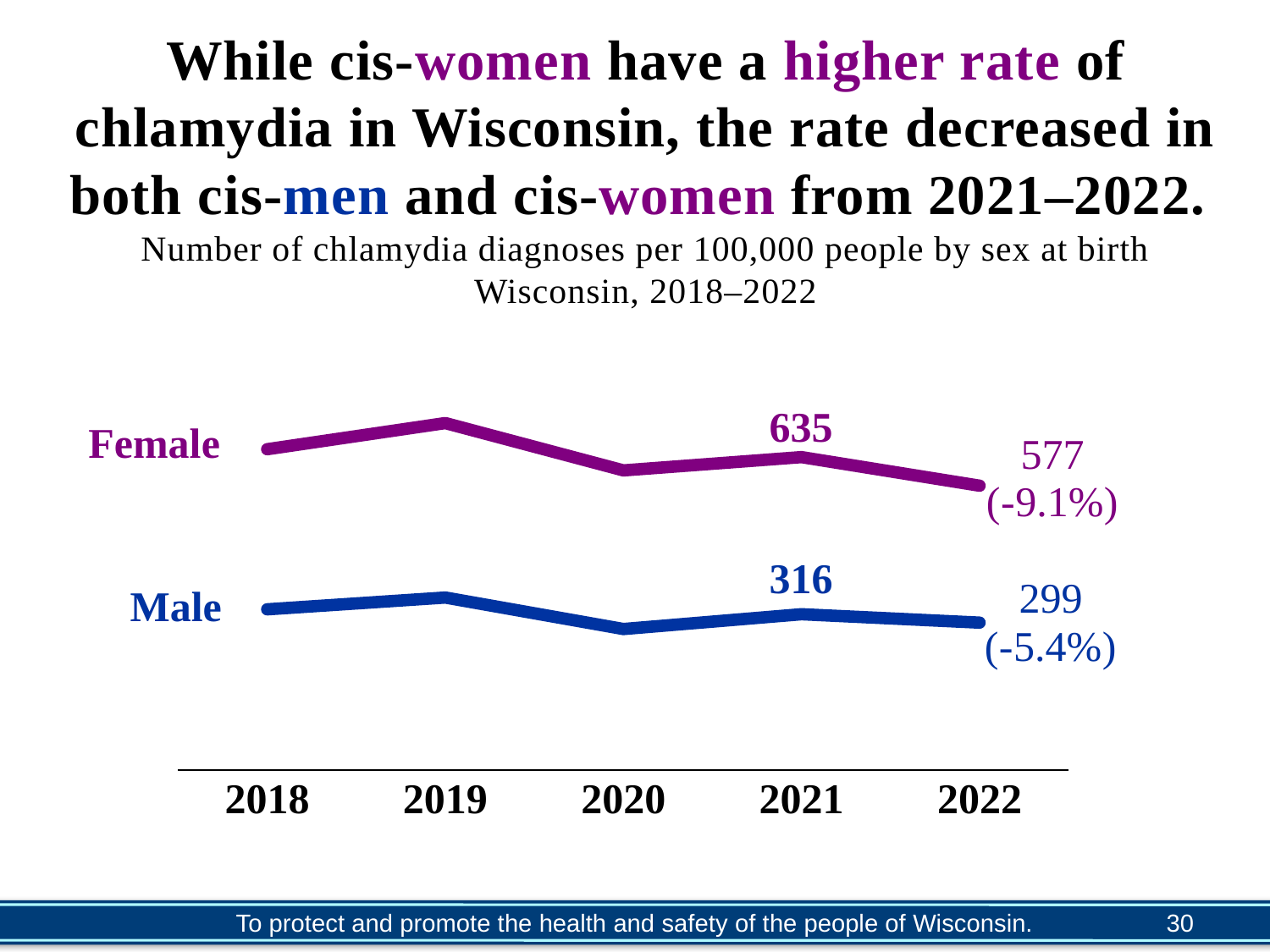
How many series are plotted on the chart? 2 What percent change is shown for the Female rate from 2021 to 2022? -9.1% What was the Female chlamydia rate in 2022? 577 What was the Female chlamydia rate in 2021? 635 What percent change is shown for the Male rate from 2021 to 2022? -5.4% How many years are shown on the x axis? 5 What kind of chart is shown on the slide? Line chart What was the Male chlamydia rate in 2022? 299 Which series has the higher rate in 2021, Female or Male? Female By how much did the Female rate fall from 2021 to 2022? 58 What is the difference between the Female and Male rates in 2022? 278 What was the Male chlamydia rate in 2021? 316